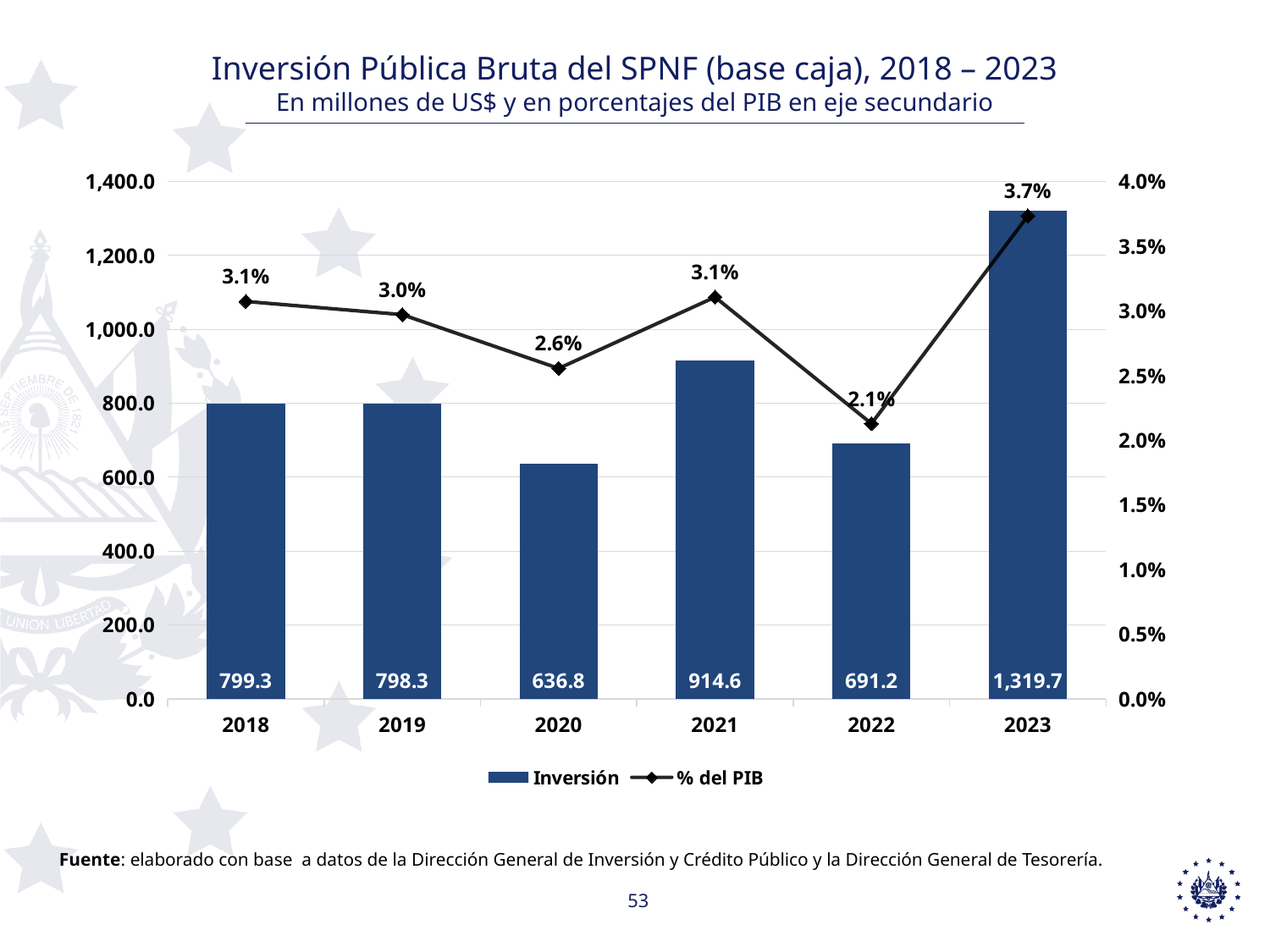
What is the % del PIB value for 2020? 2.6% What is the value of Inversión for 2023? 1,319.7 How many series does the legend list? 2 Which year has the lowest % del PIB value? 2022 Which year has the highest Inversión value? 2023 What is the difference between the Inversión values for 2023 and 2022? 628.5 What is the value of Inversión for 2021? 914.6 What kind of chart is shown on the slide? Combined bar and line chart Which is larger, the Inversión value for 2021 or for 2022? 2021 Is the Inversión value for 2020 greater or less than 800.0? less How many years are shown on the x axis? 6 Which year has the lowest Inversión value? 2020